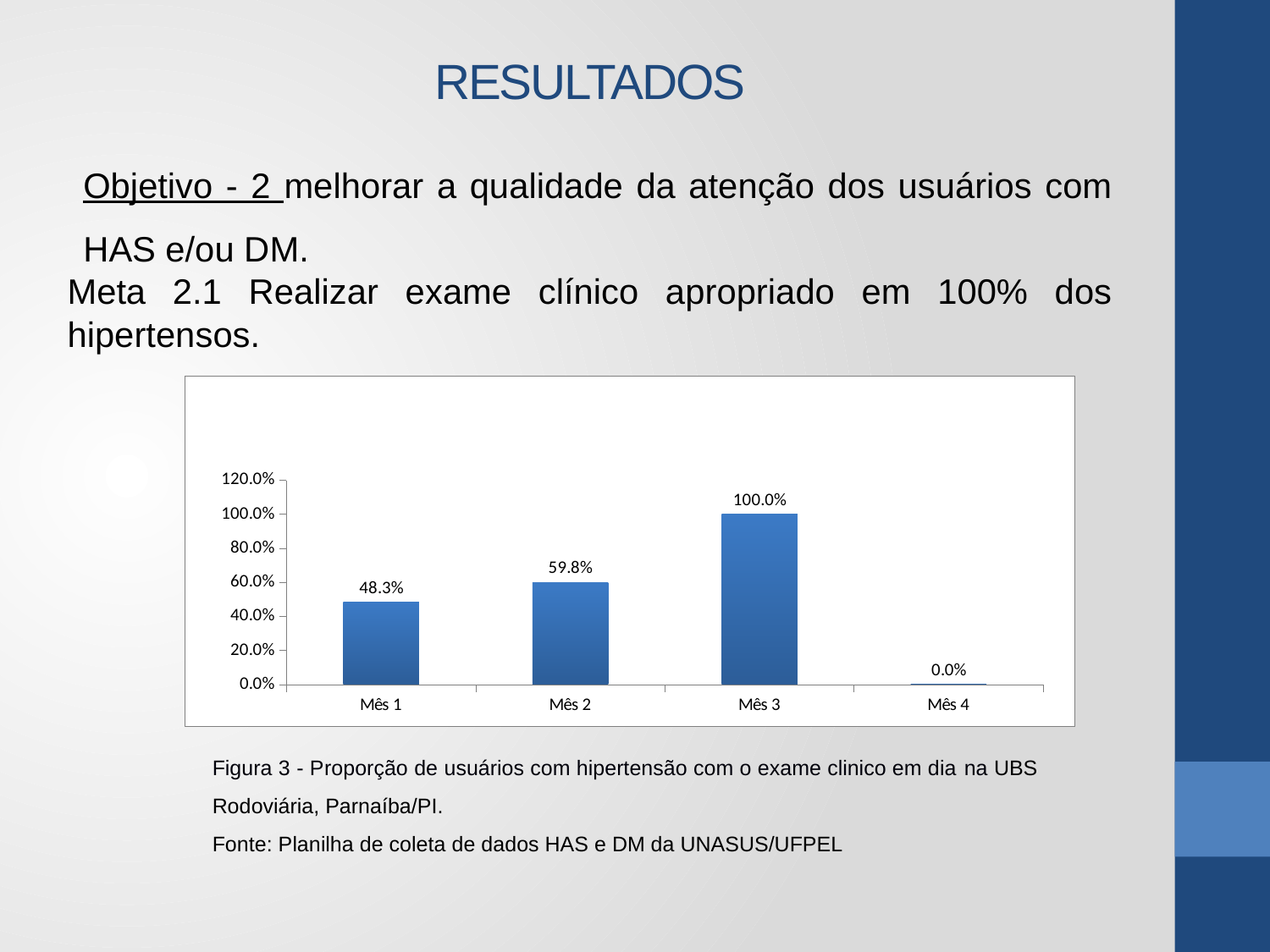
What is the value for Mês 3? 100.0% Which month has the highest value? Mês 3 What is the value for Mês 2? 59.8% Which is larger, the value for Mês 1 or the value for Mês 2? Mês 2 What is the difference between the values for Mês 2 and Mês 1? 11.5% What kind of chart is shown on the slide? bar chart What is the difference between the values for Mês 3 and Mês 2? 40.2% Is the value for Mês 1 greater or less than 60.0%? less Which month has the lowest value? Mês 4 What is the value for Mês 1? 48.3% How many months are shown on the x axis? 4 What is the value for Mês 4? 0.0%